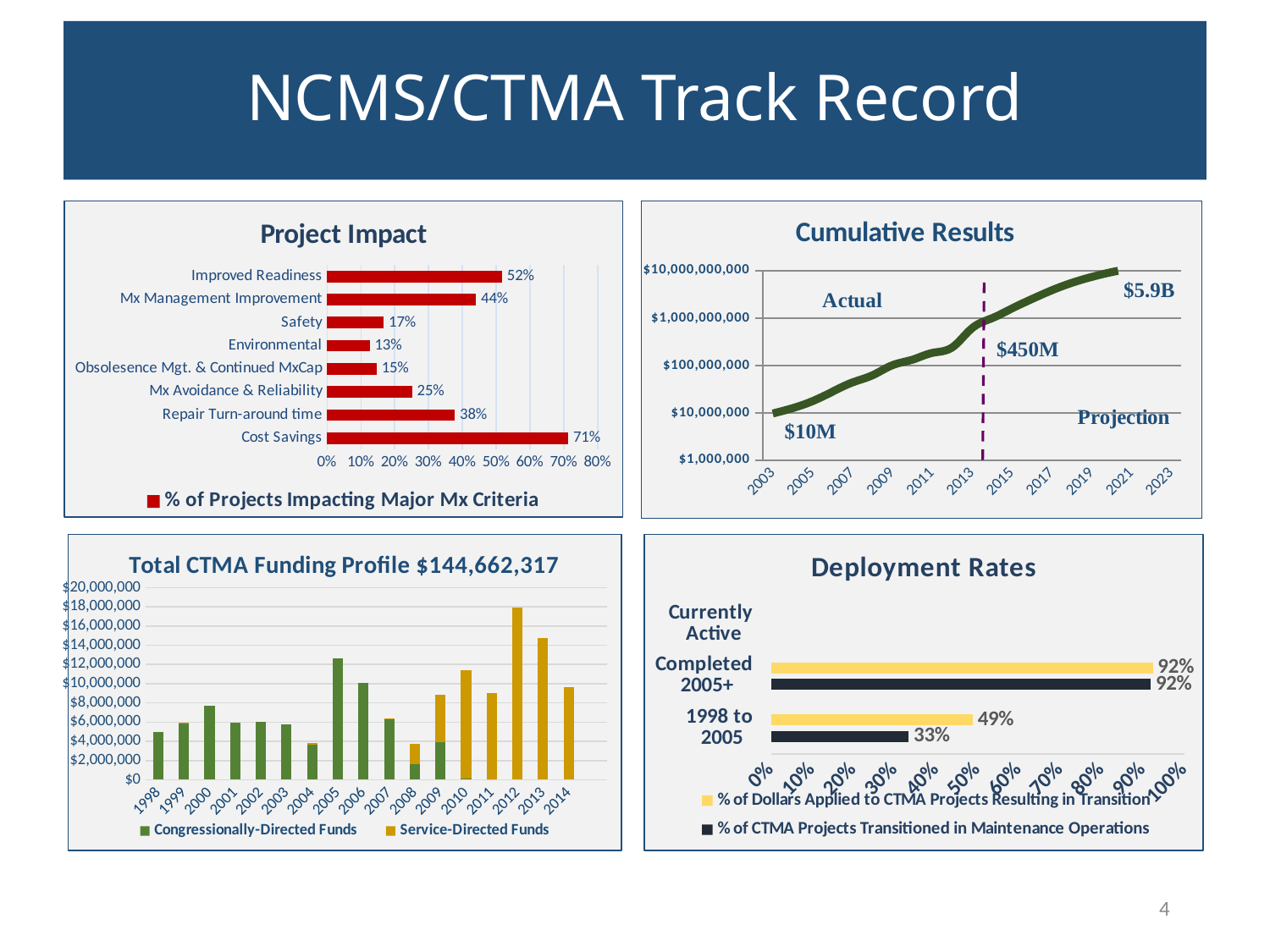
In the Total CTMA Funding Profile chart, is the total for 2012 greater or less than $16,000,000? greater In the Deployment Rates chart, what is the difference between the two values shown for 1998 to 2005? 16 percentage points What kind of chart is the Cumulative Results chart? Line chart In the Cumulative Results chart, what value is labeled at the end of the projection line? $5.9B In the Project Impact chart, how many categories are plotted? 8 In the Total CTMA Funding Profile chart, how many series does the legend list? 2 In the Project Impact chart, what is the difference between Improved Readiness and Mx Management Improvement? 8 percentage points In the Cumulative Results chart, what value is labeled near the dashed line separating Actual from Projection? $450M In the Project Impact chart, what percentage is shown for Cost Savings? 71% In the Project Impact chart, which category has the lowest percentage? Environmental In the Deployment Rates chart, what is the % of CTMA Projects Transitioned in Maintenance Operations for 1998 to 2005? 33% In the Total CTMA Funding Profile chart, how many years are shown on the x axis? 17